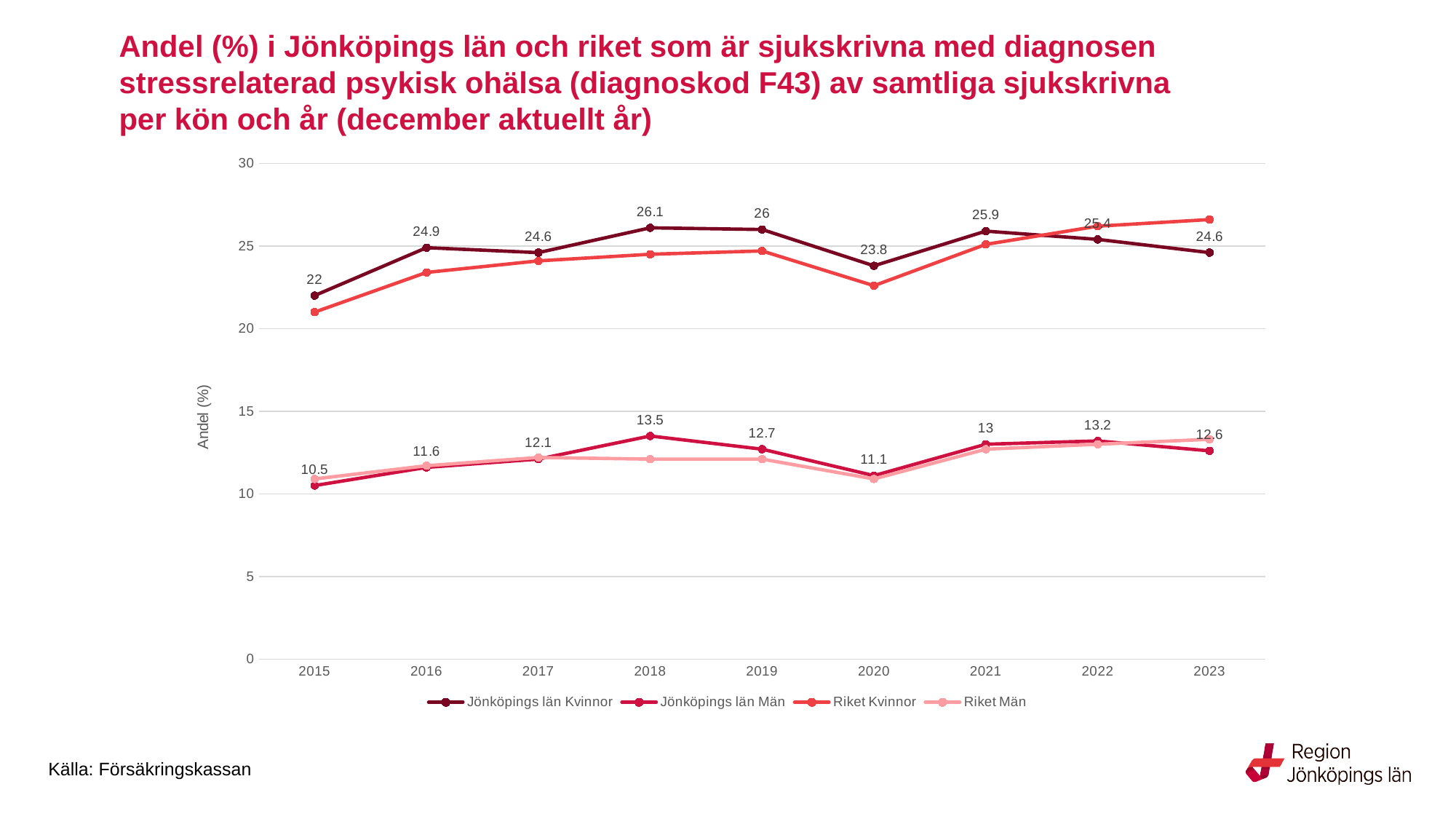
What kind of chart is shown on the slide? Line chart What is the value for Jönköpings län Män in 2020? 11.1 What is the difference between the Jönköpings län Kvinnor values in 2018 and 2020? 2.3 Is the value for Riket Kvinnor in 2015 greater or less than 25? less Which is larger for Jönköpings län Män: the value in 2018 or the value in 2023? 2018 In which year is the value for Jönköpings län Kvinnor highest? 2018 How many series does the legend list? 4 How many years are plotted along the x axis? 9 In which year is the value for Jönköpings län Män lowest? 2015 What is the value for Jönköpings län Kvinnor in 2018? 26.1 What is the label on the y axis? Andel (%) Does the value for Jönköpings län Män rise or fall from 2015 to 2018? Rise